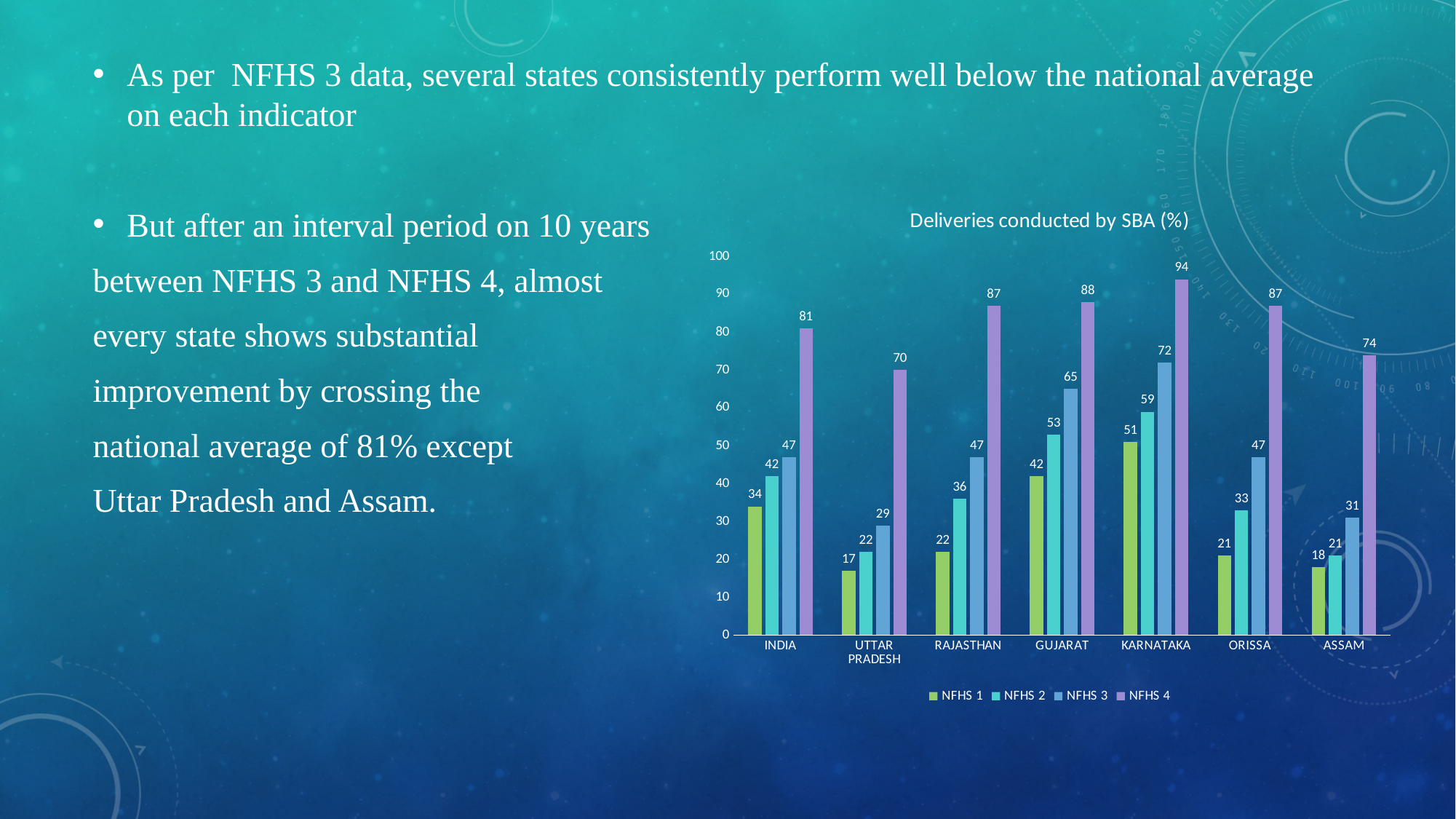
Which category has the highest NFHS 4 value? Karnataka What is the title of the chart? Deliveries conducted by SBA (%) Which is larger, the NFHS 3 value for Karnataka or the NFHS 3 value for Orissa? Karnataka What is the NFHS 3 value for Gujarat? 65 Which category has the lowest NFHS 2 value? Assam What is the difference between the NFHS 4 and NFHS 3 values for Uttar Pradesh? 41 What kind of chart is shown? bar chart What is the NFHS 1 value for Uttar Pradesh? 17 Is the NFHS 4 value for Assam greater or less than 70? greater How many series does the legend list? 4 What is the NFHS 4 value for Karnataka? 94 How many categories are shown on the x axis? 7